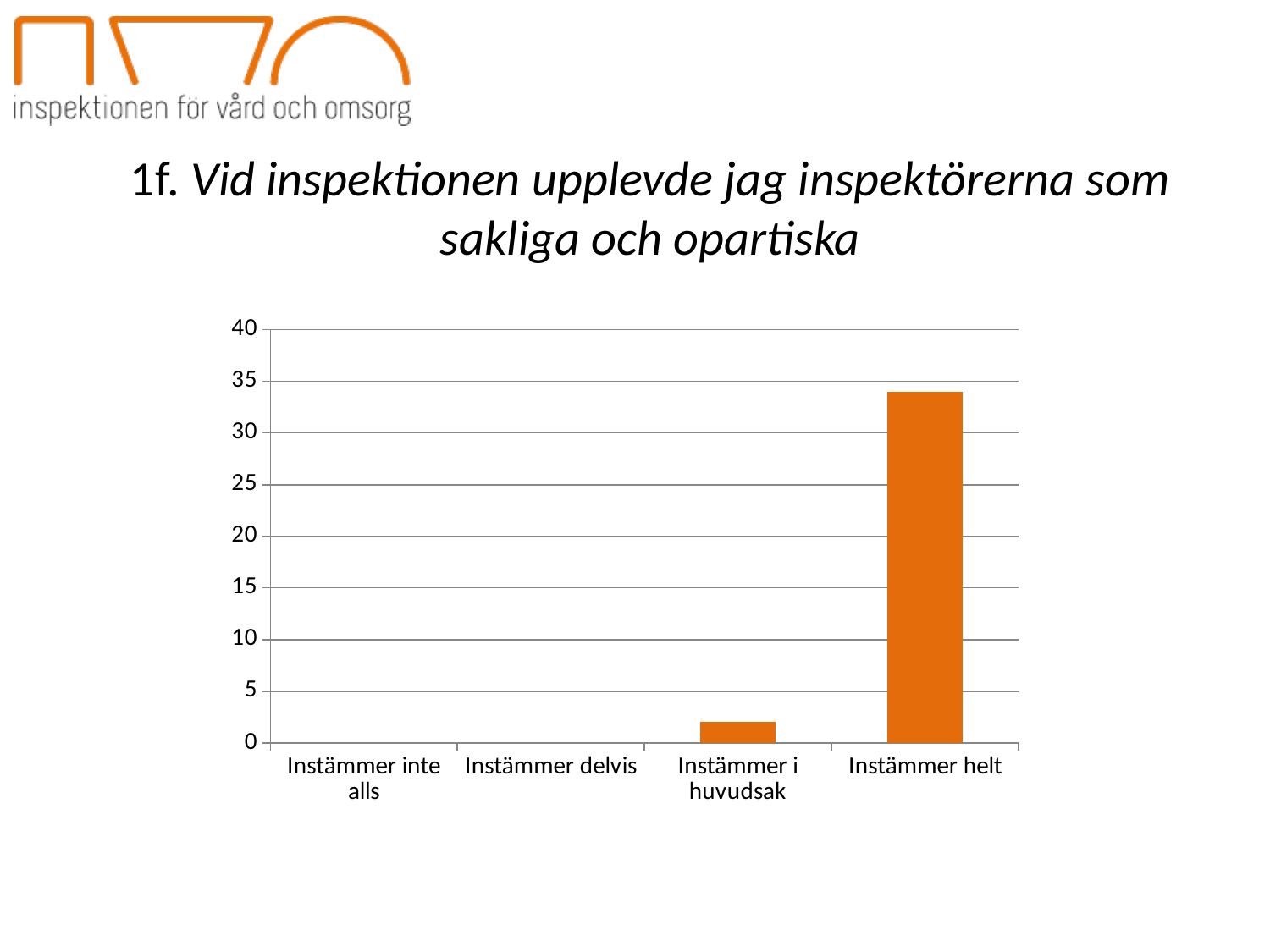
Is the value for Instämmer i huvudsak greater or less than 5? less Do the values generally rise or fall from left to right along the x axis? rise What colour are the bars in the chart? orange What is the title of the slide containing the chart? 1f. Vid inspektionen upplevde jag inspektörerna som sakliga och opartiska What kind of chart is shown on the slide? bar chart Which category has the highest bar in the chart? Instämmer helt How many categories are shown on the x axis of the chart? 4 Which is larger, the value for Instämmer helt or the value for Instämmer i huvudsak? Instämmer helt Is the value for Instämmer helt greater or less than 20? greater Is the value for Instämmer helt greater or less than 30? greater